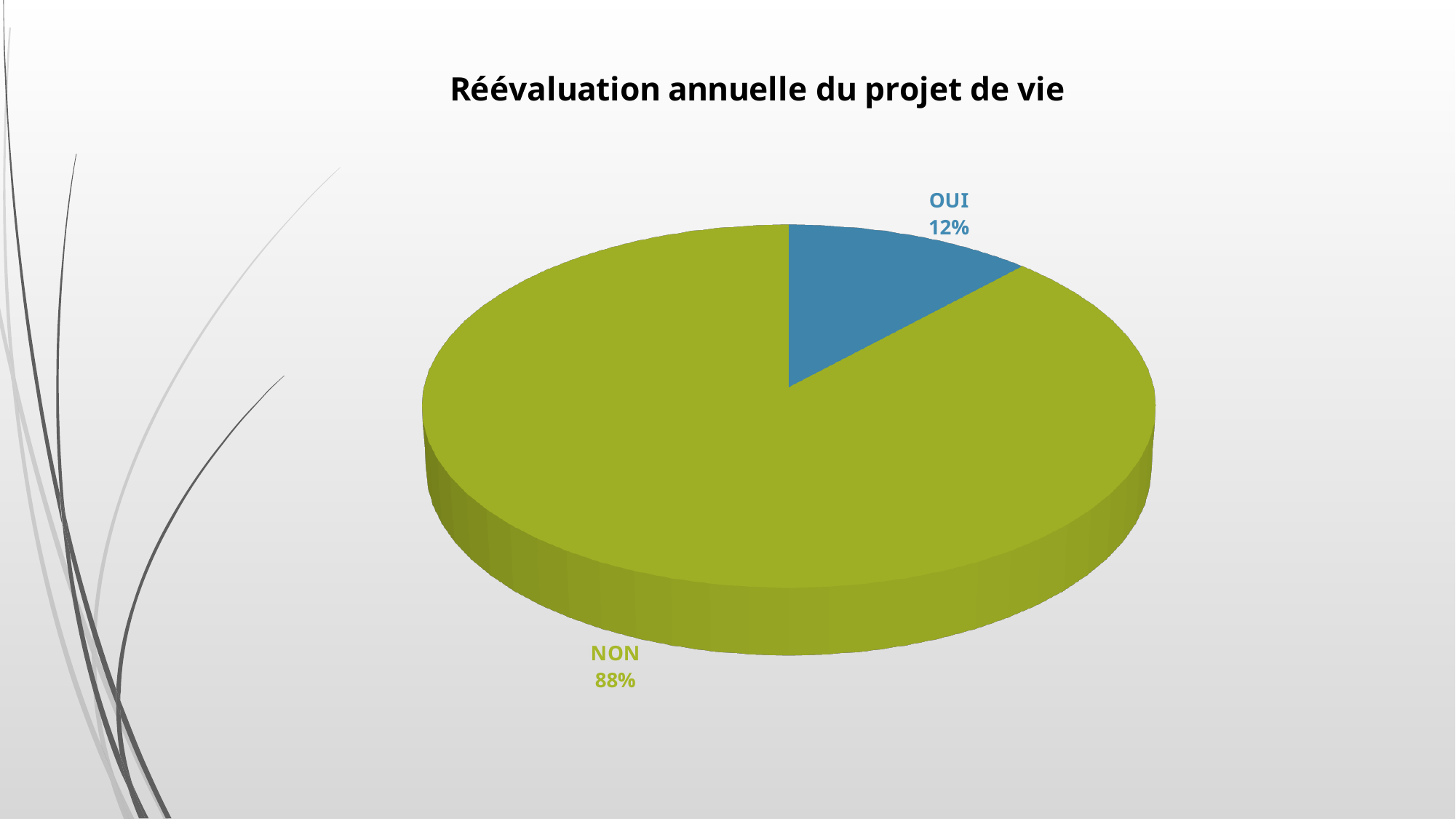
How many slices does the pie chart have? 2 Which slice is the largest? NON What share of the pie does the OUI slice represent? 12% What colour is the OUI slice? blue Is the value for NON greater or less than 50%? greater What share of the pie does the NON slice represent? 88% What is the title of the chart? Réévaluation annuelle du projet de vie Which slice is the smallest? OUI Which is larger, the OUI slice or the NON slice? NON What is the difference in percentage points between the NON and OUI slices? 76 What kind of chart is shown on the slide? pie chart